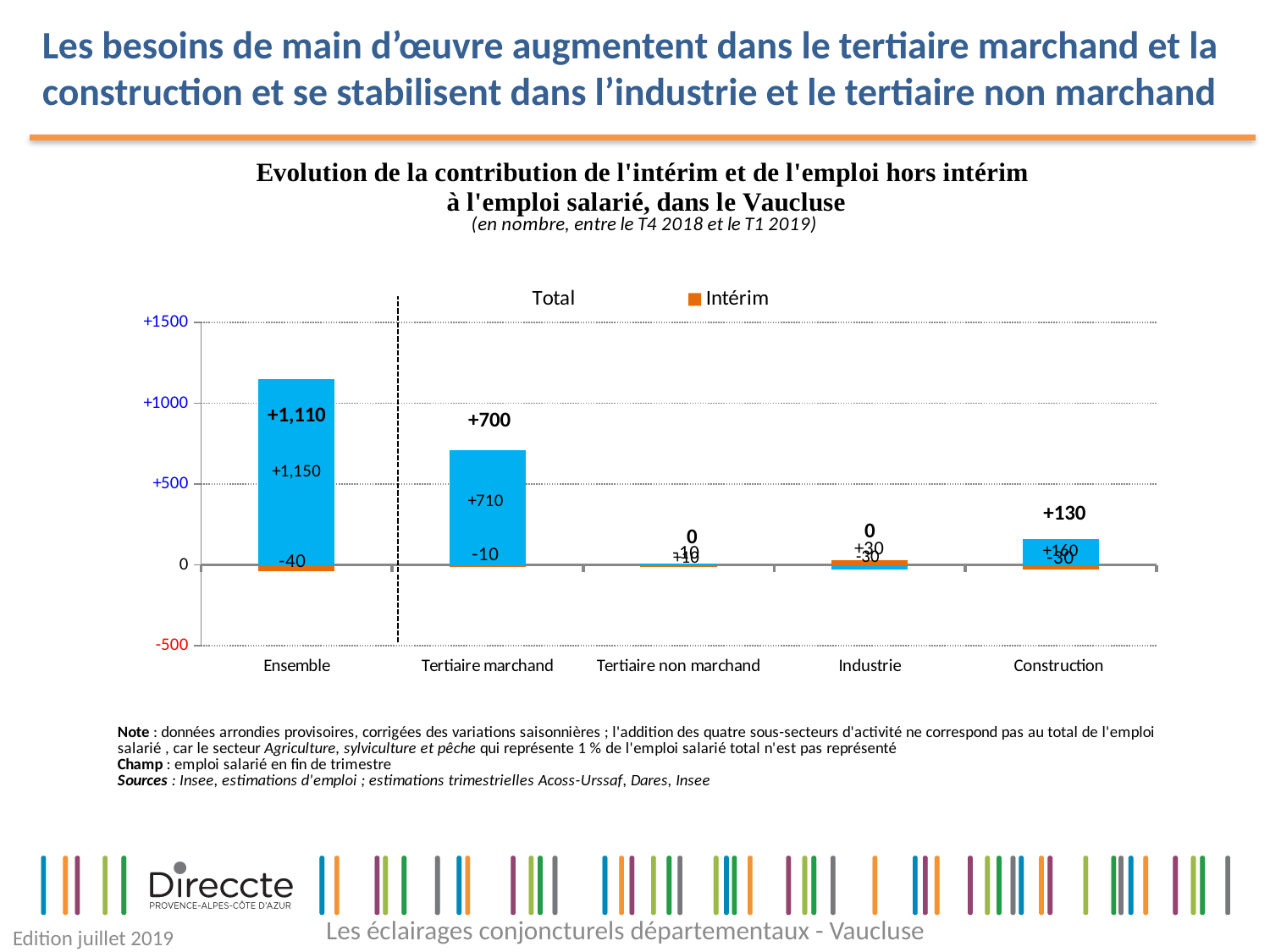
What is the total value shown for Construction? +130 What is the total value shown above the Ensemble bar? +1,110 What is the value of the blue segment for Ensemble? +1,150 Which category has the highest total value? Ensemble What is the Intérim value for Ensemble? -40 What is the total value shown for Tertiaire marchand? +700 How many categories are shown on the x axis? 5 What kind of chart is shown on the slide? bar chart What is the Intérim value for Tertiaire marchand? -10 What is the difference between the total for Ensemble and the total for Tertiaire marchand? 410 Which has a larger total value, Tertiaire marchand or Construction? Tertiaire marchand Is the blue segment for Tertiaire marchand greater or less than 500? greater